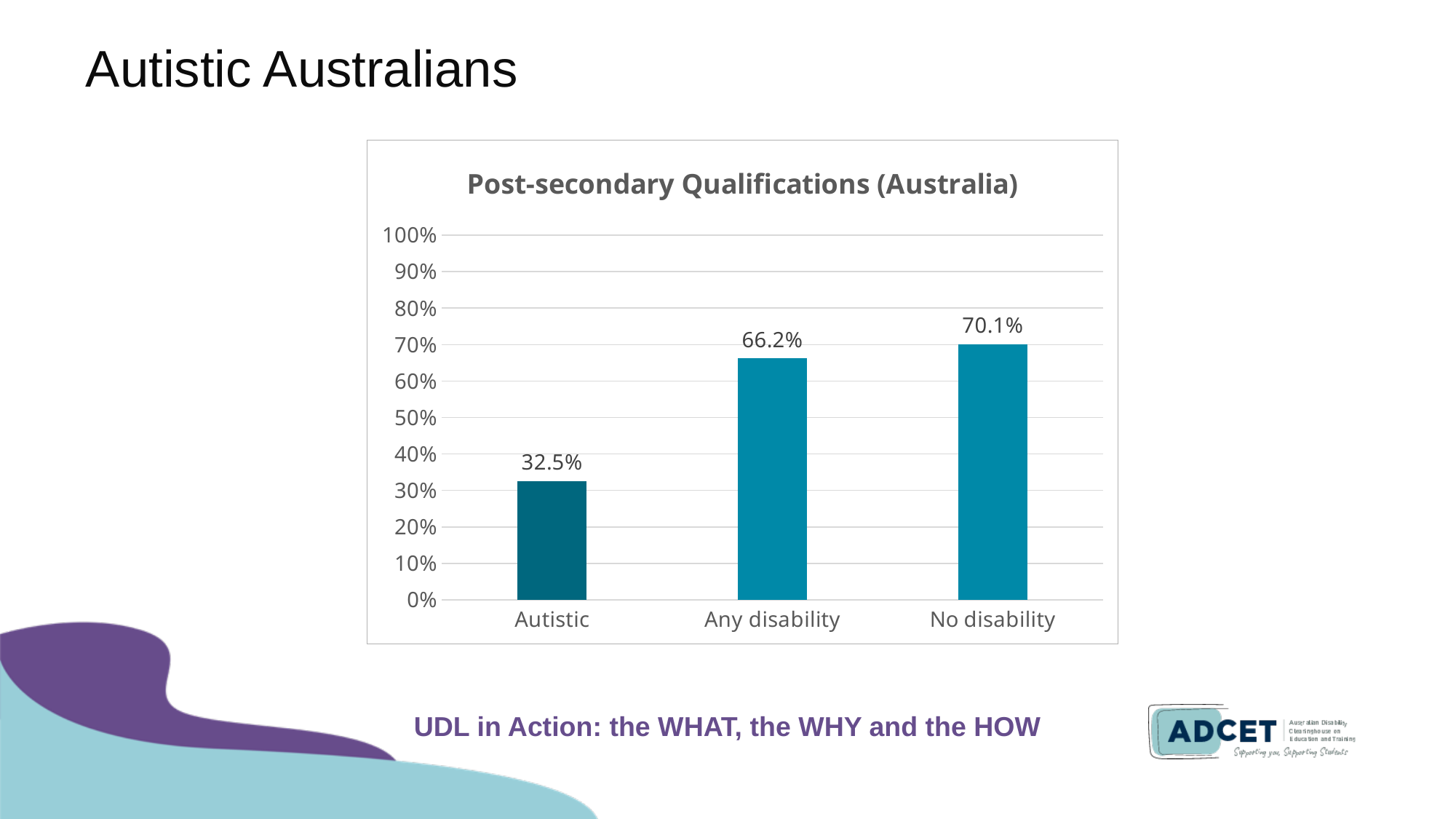
What is the title of the chart? Post-secondary Qualifications (Australia) What is the value for Any disability? 66.2% Which is larger, the value for Autistic or the value for Any disability? Any disability What is the difference between the values for No disability and Any disability? 3.9% What is the difference between the values for No disability and Autistic? 37.6% What kind of chart is shown on the slide? bar chart What is the value for Autistic? 32.5% Which category has the highest value? No disability Is the value for Autistic greater or less than 40%? less How many categories are shown on the x axis? 3 What is the value for No disability? 70.1% Which category has the lowest value? Autistic